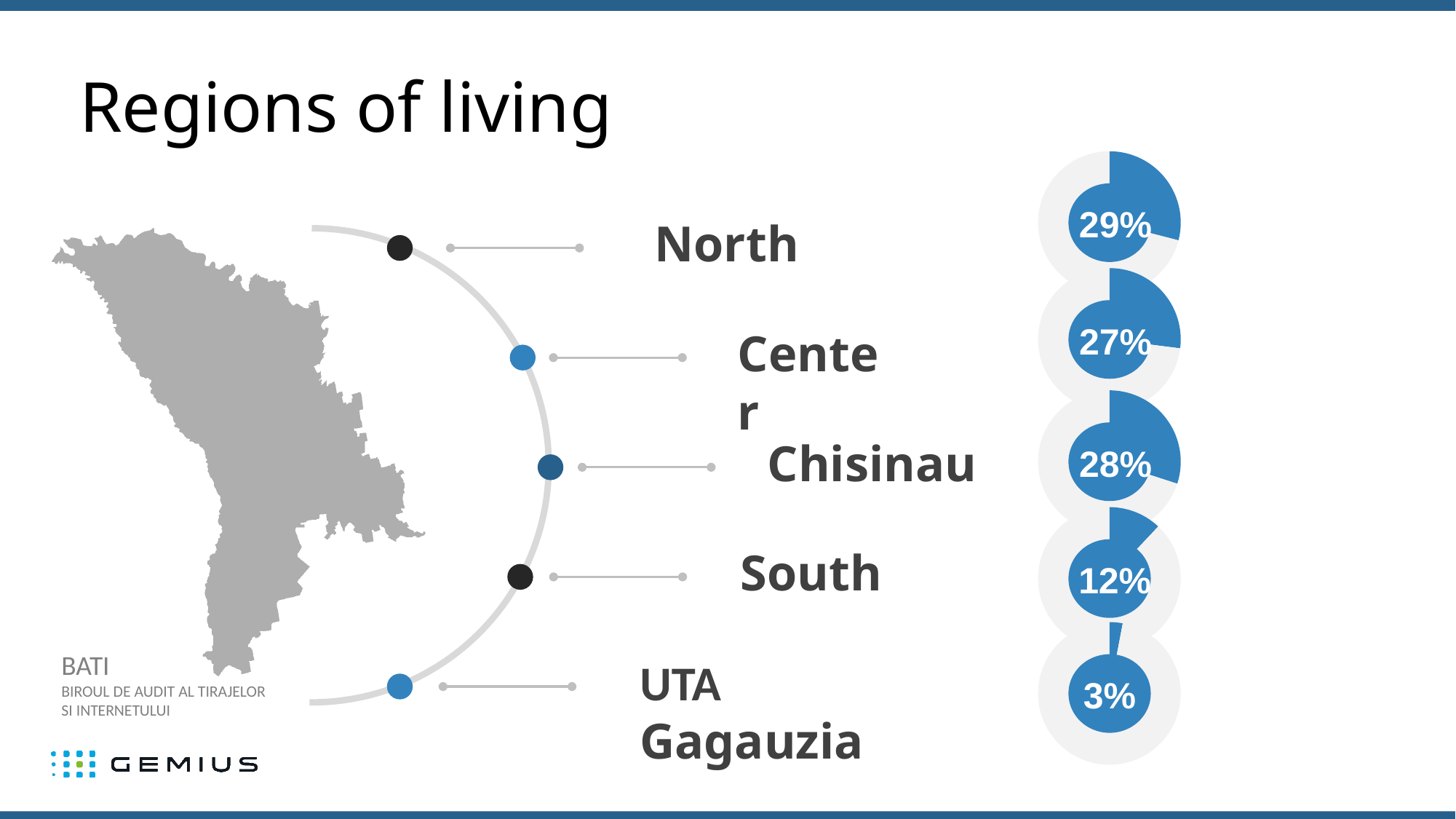
What kind of chart is used to show each region's percentage? Pie chart What is the title of the slide? Regions of living What percentage is shown for Chisinau? 28% What percentage is shown for UTA Gagauzia? 3% How many regions are shown on the slide? 5 Which region has the highest share of living? North What percentage is shown for the South region? 12% What percentage is shown for the Center region? 27% Which region has the lowest share of living? UTA Gagauzia What percentage of people live in the North region? 29% What is the difference in percentage points between North and South? 17 Which has a larger share, Center or Chisinau? Chisinau